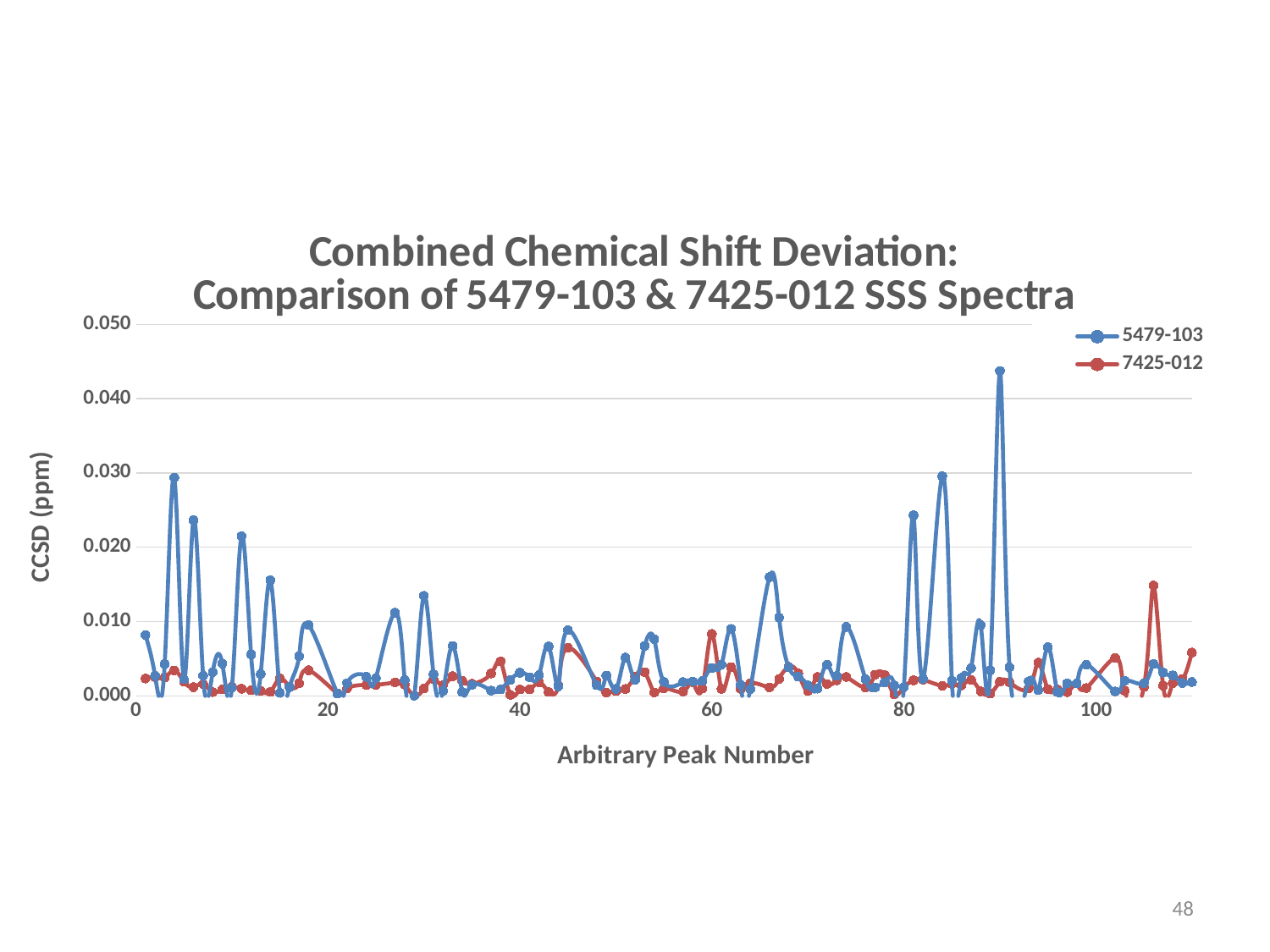
Which series has the larger value at peak 106, 5479-103 or 7425-012? 7425-012 What kind of chart is shown on the slide? Line chart Which series reaches the highest CCSD value on the chart? 5479-103 Is the 5479-103 value at peak 4 greater or less than 0.020? greater Is the highest value of the 7425-012 series (near peak 106) greater or less than 0.010? greater Is the highest value of the 7425-012 series greater or less than 0.020? less What is the title of the chart? Combined Chemical Shift Deviation: Comparison of 5479-103 & 7425-012 SSS Spectra How many series does the legend list? 2 Which series has the larger value at peak 90, 5479-103 or 7425-012? 5479-103 What is the label of the y axis? CCSD (ppm)